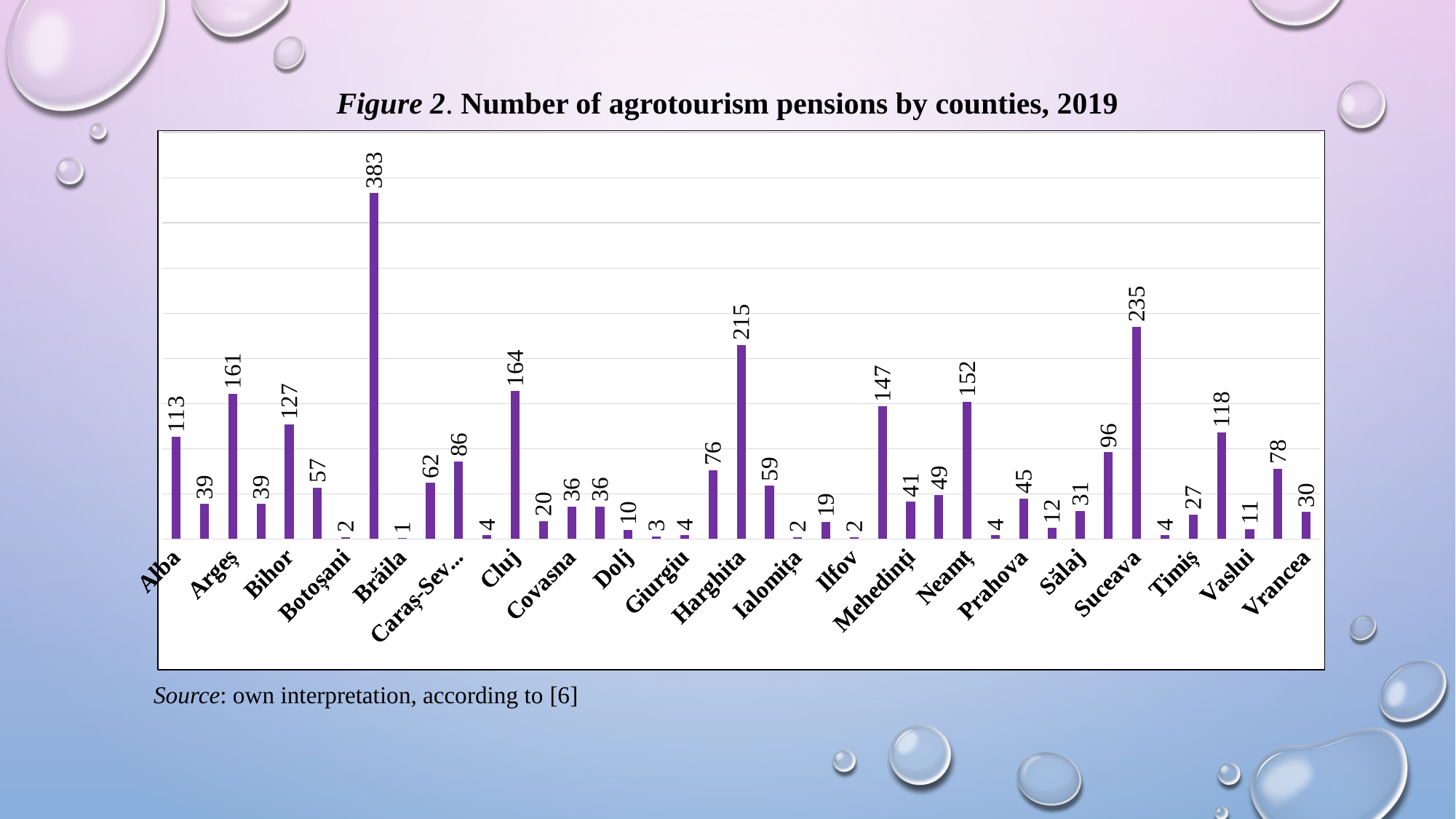
What is the number of agrotourism pensions for Harghita? 215 What is the title of the chart? Figure 2. Number of agrotourism pensions by counties, 2019 What is the number of agrotourism pensions for Alba? 113 What source is cited below the chart? own interpretation, according to [6] What is the difference between the values for Suceava and Harghita? 20 What is the number of agrotourism pensions for Neamț? 152 What is the lowest value shown on the chart? 1 What kind of chart is shown on the slide? bar chart Which has more agrotourism pensions, Harghita or Cluj? Harghita What is the highest value shown on the chart? 383 What is the number of agrotourism pensions for Suceava? 235 What is the number of agrotourism pensions for Cluj? 164